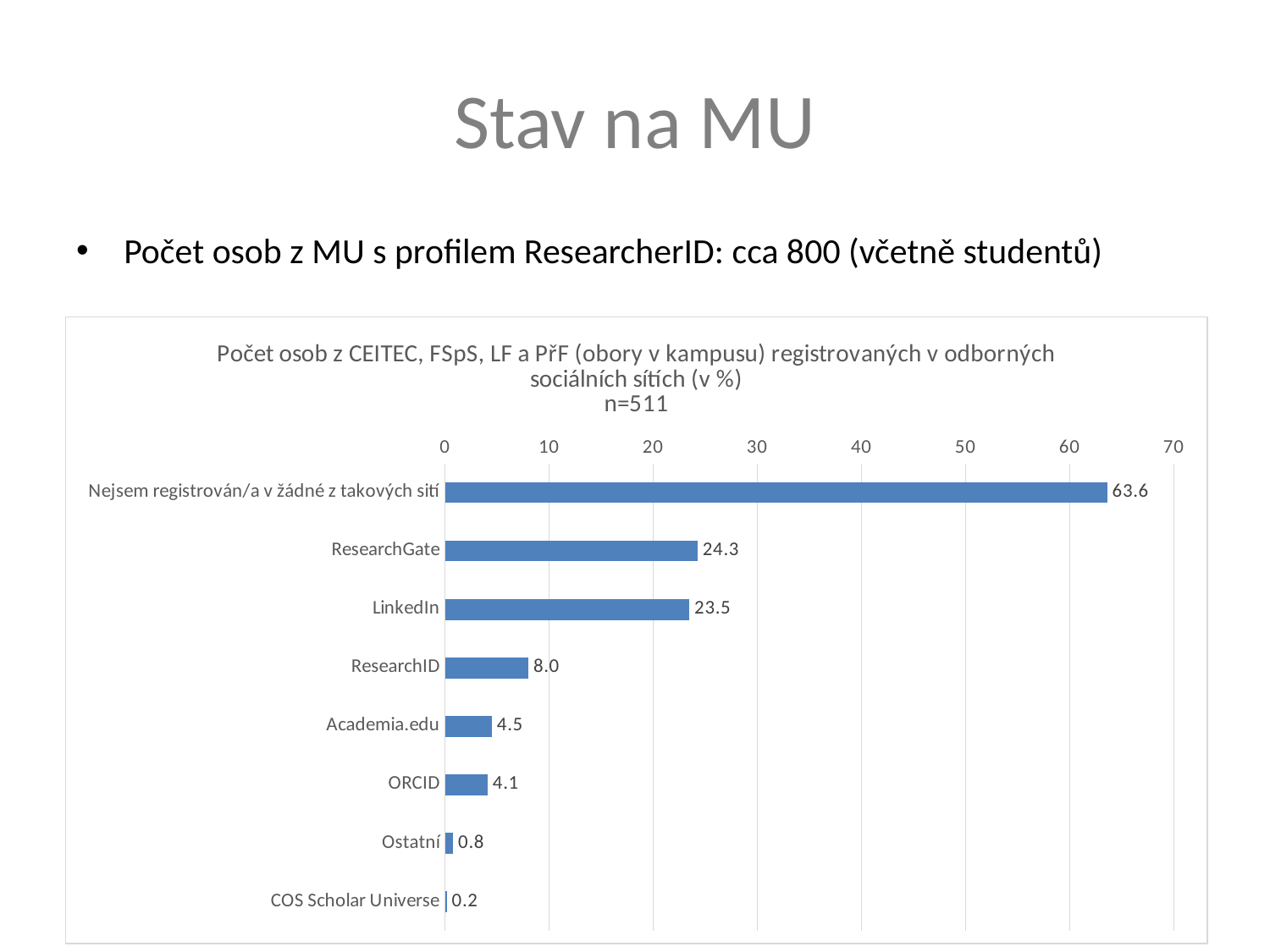
How many categories are shown in the chart? 8 Which is larger, the value for ResearchID or the value for Academia.edu? ResearchID What is the difference between the values for ResearchGate and LinkedIn? 0.8 What is the value for COS Scholar Universe? 0.2 What is the value for ORCID? 4.1 Is the value for LinkedIn greater or less than 20? greater Which category has the highest value? Nejsem registrován/a v žádné z takových sítí What kind of chart is shown on the slide? bar chart Which category has the lowest value? COS Scholar Universe What is the sample size (n) stated in the chart title? 511 What is the difference between the values for Academia.edu and ORCID? 0.4 What is the value for ResearchGate? 24.3